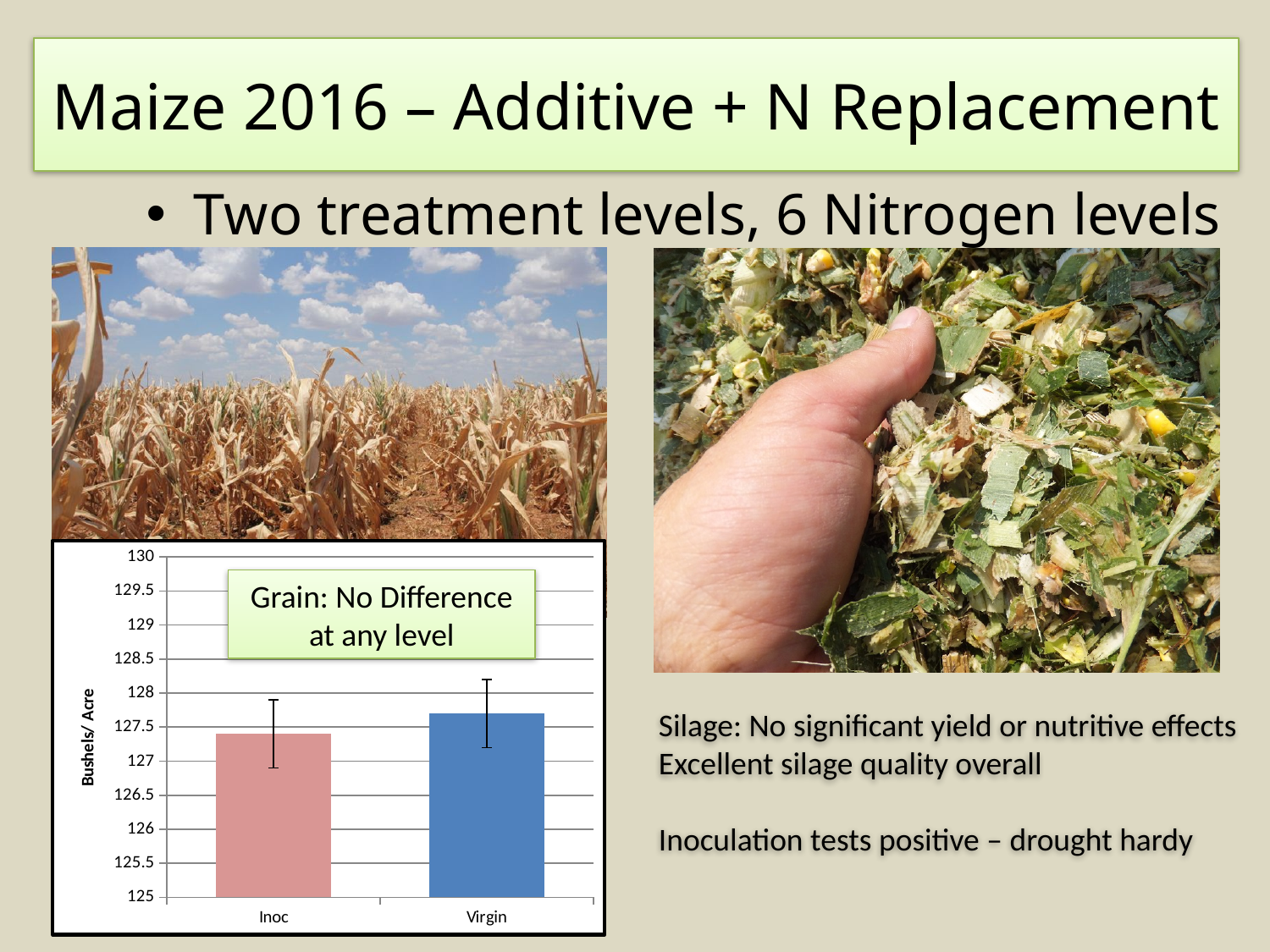
What does the text box inside the chart say? Grain: No Difference at any level Is the value for Inoc greater or less than 127? greater Is the value for Virgin greater or less than 127? greater Which category has the lowest bar on the chart? Inoc Is the value for Inoc greater or less than 128? less Which category has the taller bar, Inoc or Virgin? Virgin What is the label on the vertical axis of the chart? Bushels/ Acre How many categories are plotted on the bar chart? 2 What kind of chart is shown on the slide? bar chart